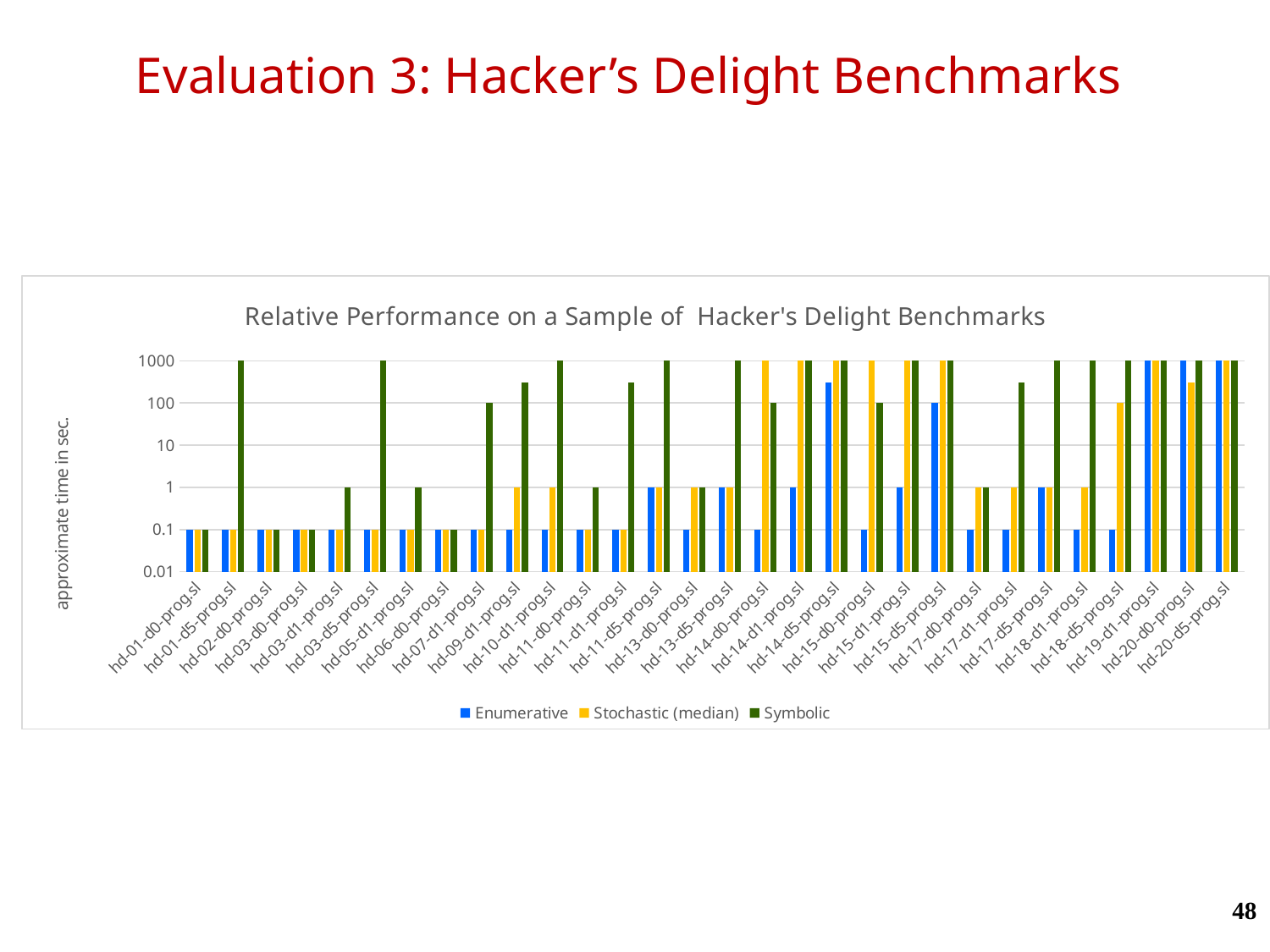
For hd-14-d0-prog.sl, which is larger: the Stochastic (median) value or the Symbolic value? Stochastic (median) What is the Enumerative value for hd-15-d5-prog.sl? 100 Is the Symbolic value for hd-09-d1-prog.sl greater or less than 100? greater What is the title of the chart? Relative Performance on a Sample of Hacker's Delight Benchmarks What is the Stochastic (median) value for hd-11-d5-prog.sl? 1 How many benchmark categories are plotted along the x axis? 30 What is the Symbolic value for hd-07-d1-prog.sl? 100 How many series does the legend list? 3 Is the Enumerative value for hd-14-d5-prog.sl greater or less than 100? greater What kind of chart is shown on the slide? bar chart What is the Symbolic value for hd-01-d5-prog.sl? 1000 What is the label on the vertical axis of the chart? approximate time in sec.